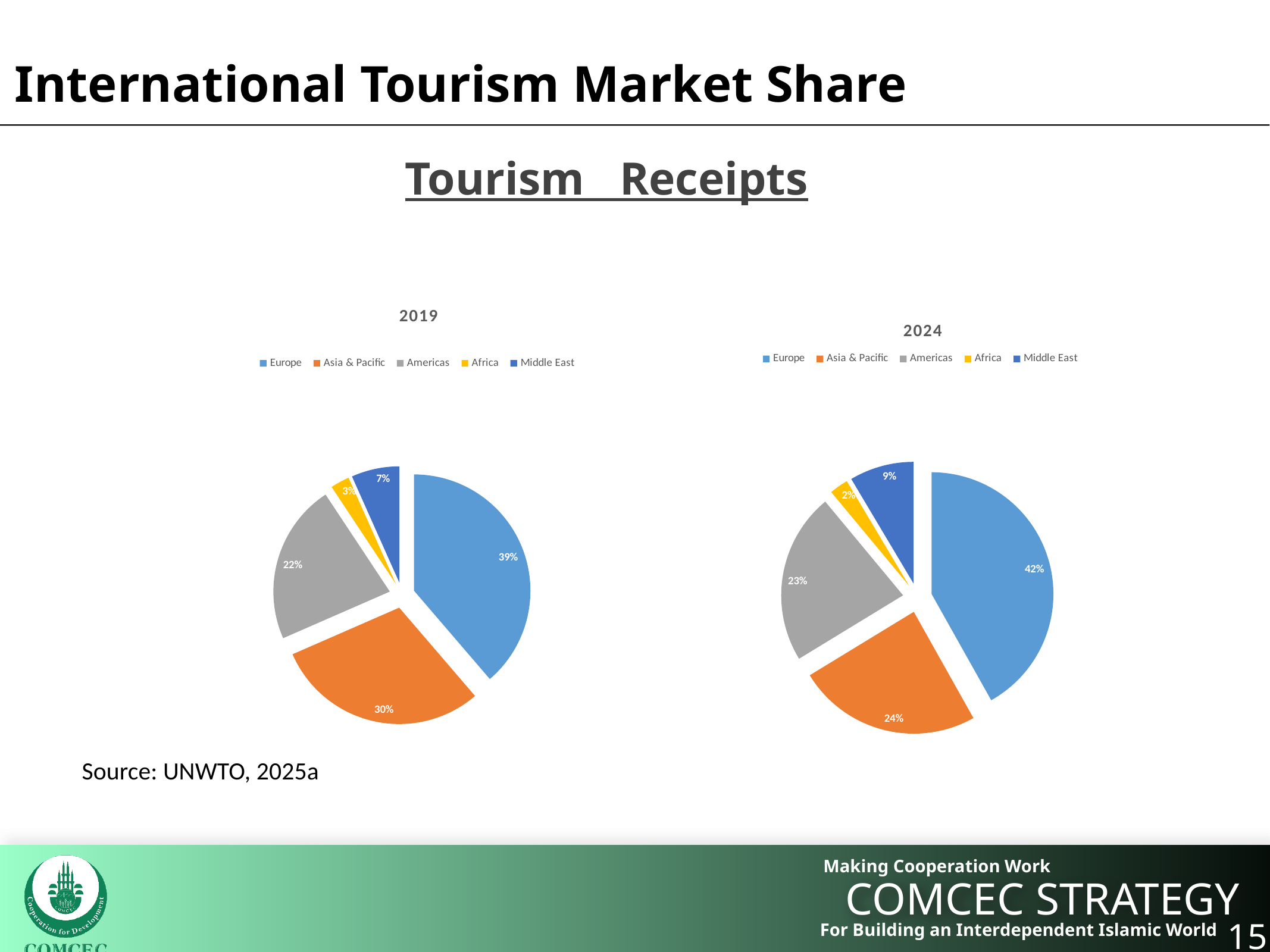
Which colour represents the Americas in the pie charts? Grey In the 2024 pie chart, what is the value for the Middle East? 9% In the 2019 pie chart, which region has the largest share? Europe In the 2024 pie chart, what share of tourism receipts does Asia & Pacific hold? 24% In the 2019 pie chart, what is the combined share of Europe and Asia & Pacific? 69% In the 2019 pie chart, what share of tourism receipts does Europe hold? 39% In the 2019 pie chart, what is the value for Africa? 3% In the 2024 pie chart, what is the difference between Europe's share and the Americas' share? 19 percentage points In the 2019 pie chart, which is larger: the share for Asia & Pacific or the share for the Americas? Asia & Pacific What type of chart is used to show the 2024 tourism receipts? Pie chart How many regions are shown in the 2019 pie chart? 5 In the 2024 pie chart, which region has the smallest share? Africa